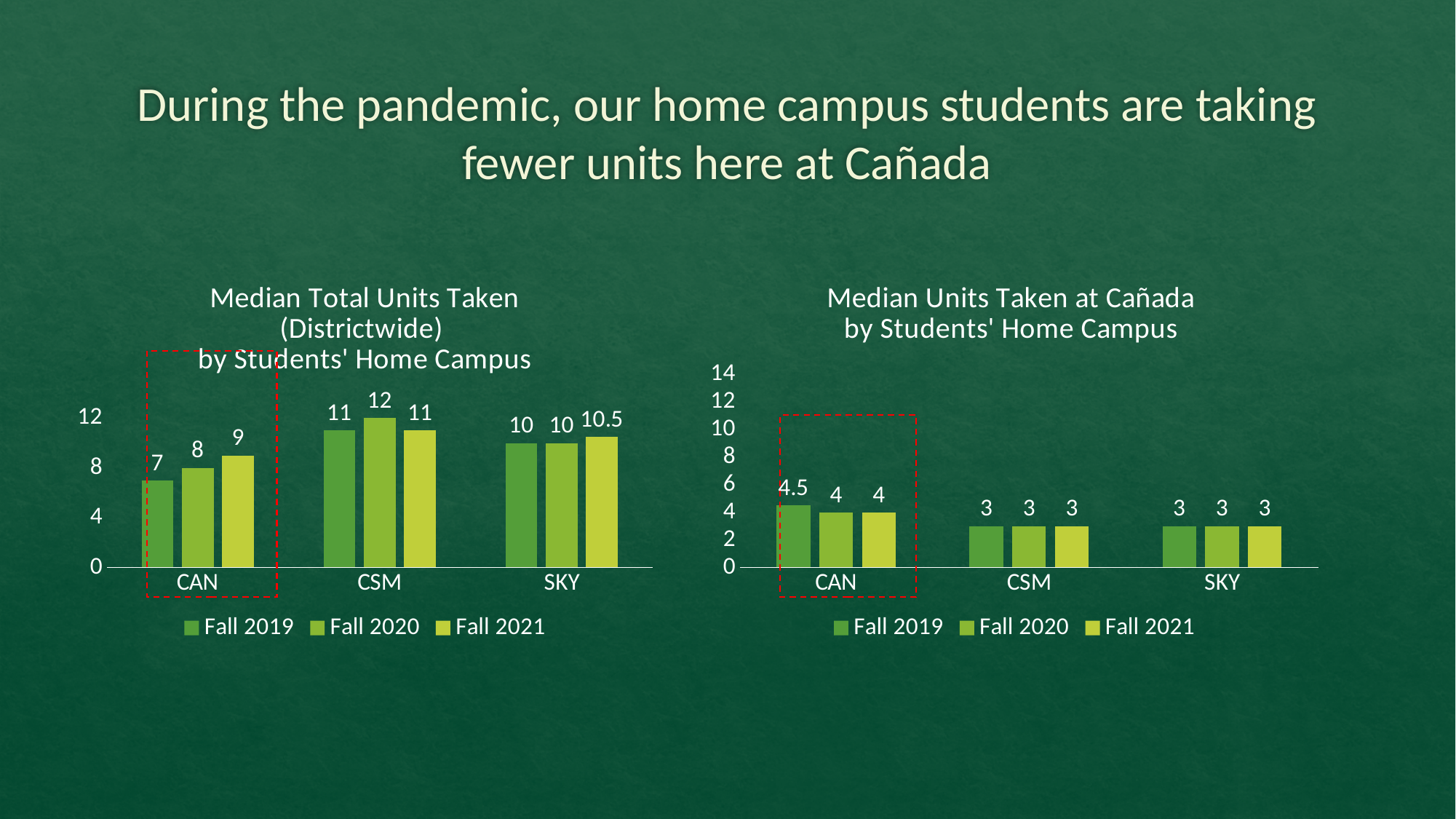
In the 'Median Units Taken at Cañada' chart, what is the difference between the CAN values for Fall 2019 and Fall 2020? 0.5 In the 'Median Units Taken at Cañada' chart, what is the value for CAN in Fall 2019? 4.5 How many series does the legend of the 'Median Total Units Taken (Districtwide)' chart list? 3 In the 'Median Total Units Taken (Districtwide)' chart, which campus has the highest Fall 2020 value? CSM In the 'Median Units Taken at Cañada' chart, which is larger: the CAN value for Fall 2021 or the CSM value for Fall 2021? CAN In the 'Median Total Units Taken (Districtwide)' chart, what is the value for SKY in Fall 2021? 10.5 In the 'Median Total Units Taken (Districtwide)' chart, what is the difference between the CSM and CAN values for Fall 2019? 4 How many campus categories are shown on the x axis of the 'Median Units Taken at Cañada' chart? 3 In the 'Median Total Units Taken (Districtwide)' chart, which campus has the lowest Fall 2019 value? CAN What type of chart is the 'Median Units Taken at Cañada by Students' Home Campus' chart? Bar chart In the 'Median Total Units Taken (Districtwide)' chart, do the CAN values rise or fall from Fall 2019 to Fall 2021? Rise In the 'Median Total Units Taken (Districtwide)' chart, what is the value for CAN in Fall 2021? 9